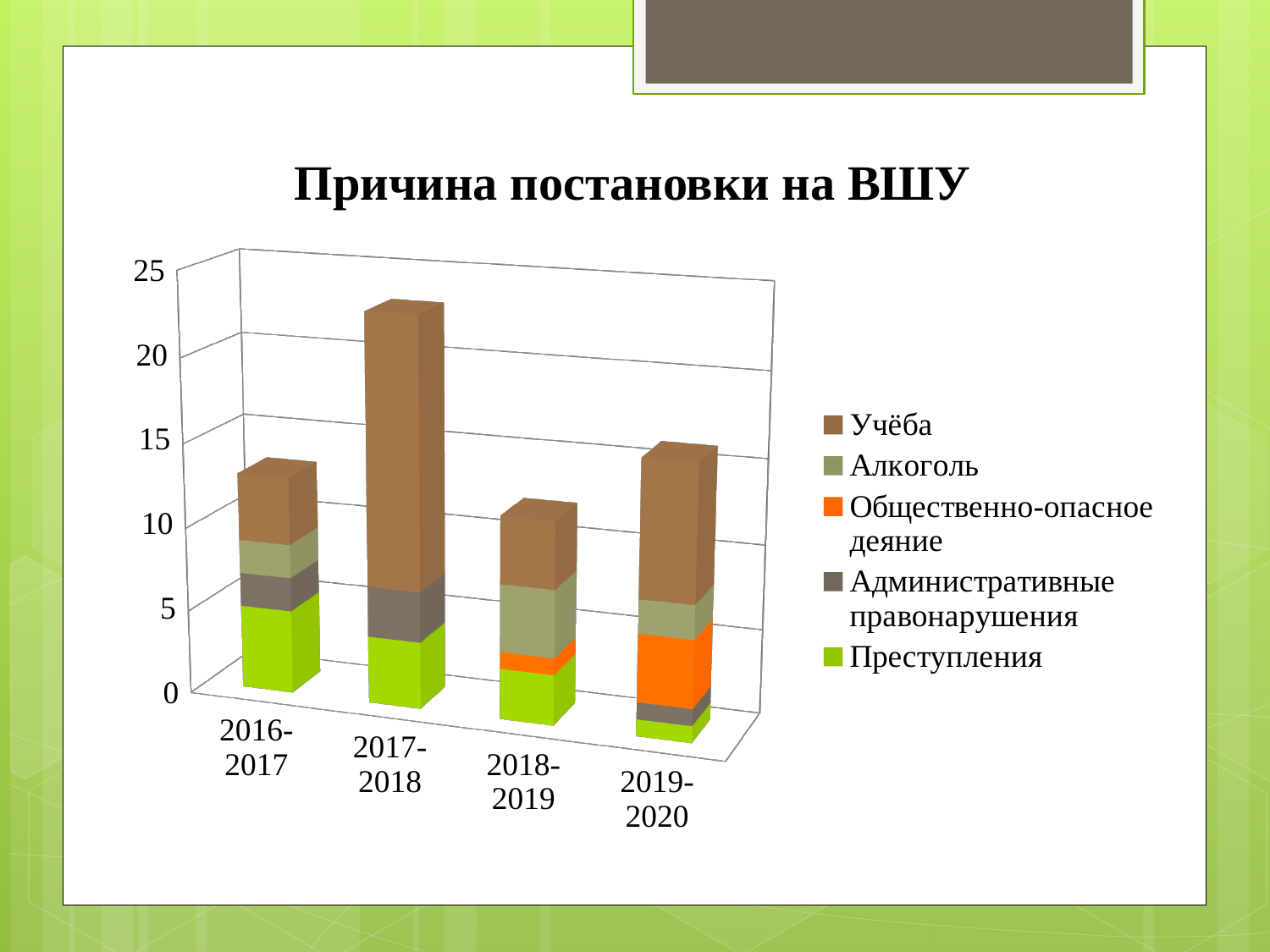
Which legend entry is shown in bright green? Преступления Is the total for 2018-2019 greater or less than 15? less How many series does the legend list? 5 Is the total for 2017-2018 greater or less than 20? greater Which school year has the shortest stacked bar? 2018-2019 Which school year has the tallest stacked bar? 2017-2018 How many categories (school years) are shown on the x axis? 4 Which stacked bar is taller, 2017-2018 or 2018-2019? 2017-2018 What is the title of the chart? Причина постановки на ВШУ Is the total for 2016-2017 greater or less than 15? less What kind of chart is shown on the slide? Stacked bar chart Which stacked bar is taller, 2017-2018 or 2019-2020? 2017-2018